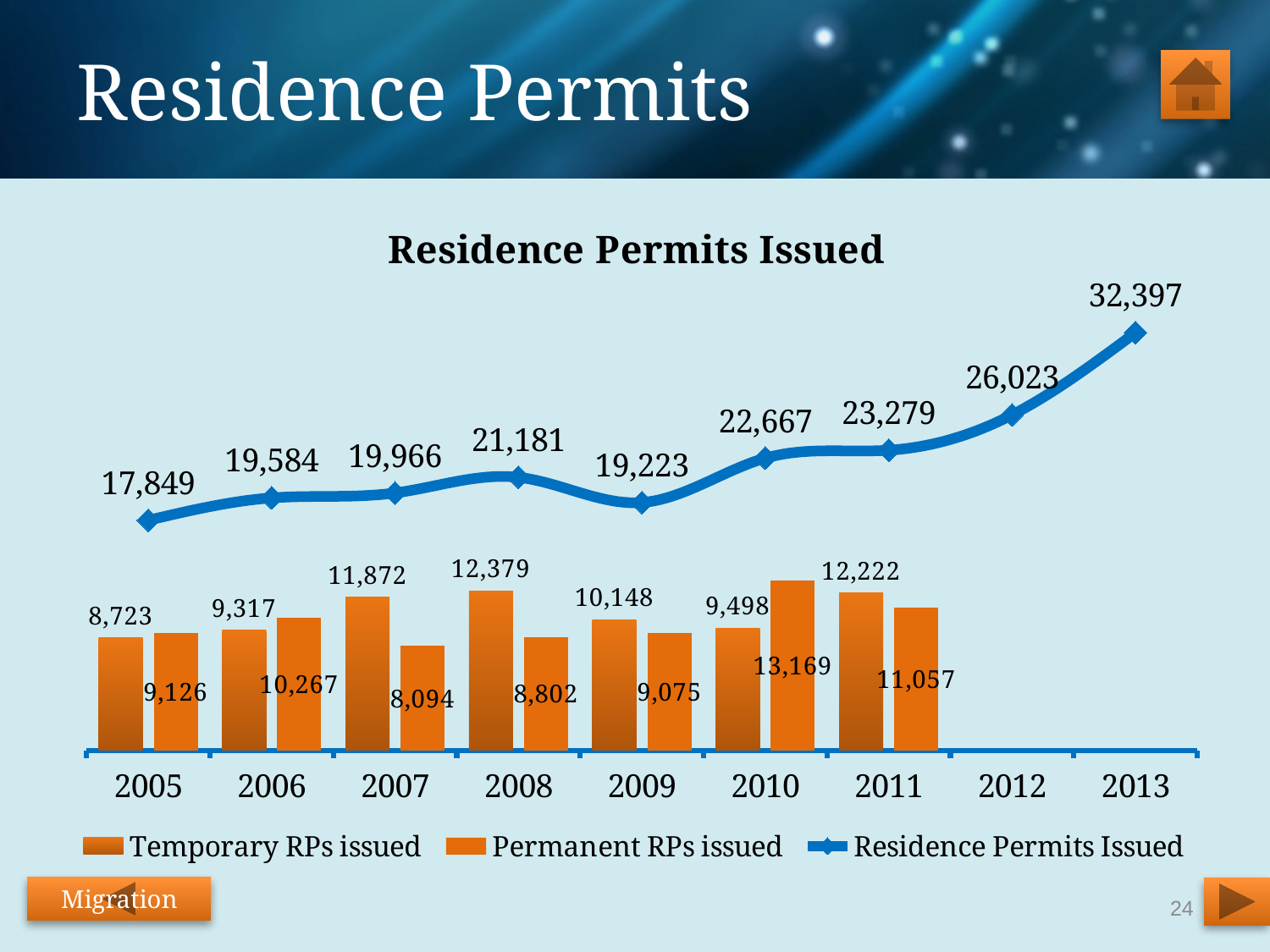
What is the difference between Residence Permits Issued in 2013 and 2012? 6,374 How many Permanent RPs were issued in 2010? 13,169 In which year is the Residence Permits Issued line at its highest? 2013 In which year is the Residence Permits Issued line at its lowest? 2005 What is the value of Residence Permits Issued for 2013? 32,397 Does the Residence Permits Issued line rise or fall from 2009 to 2013? Rise How many years are shown on the x axis? 9 How many Temporary RPs were issued in 2008? 12,379 What is the difference between Temporary RPs issued and Permanent RPs issued in 2008? 3,577 How many series does the legend list? 3 What kind of chart is this? Combination bar and line chart In 2010, which is larger: Temporary RPs issued or Permanent RPs issued? Permanent RPs issued